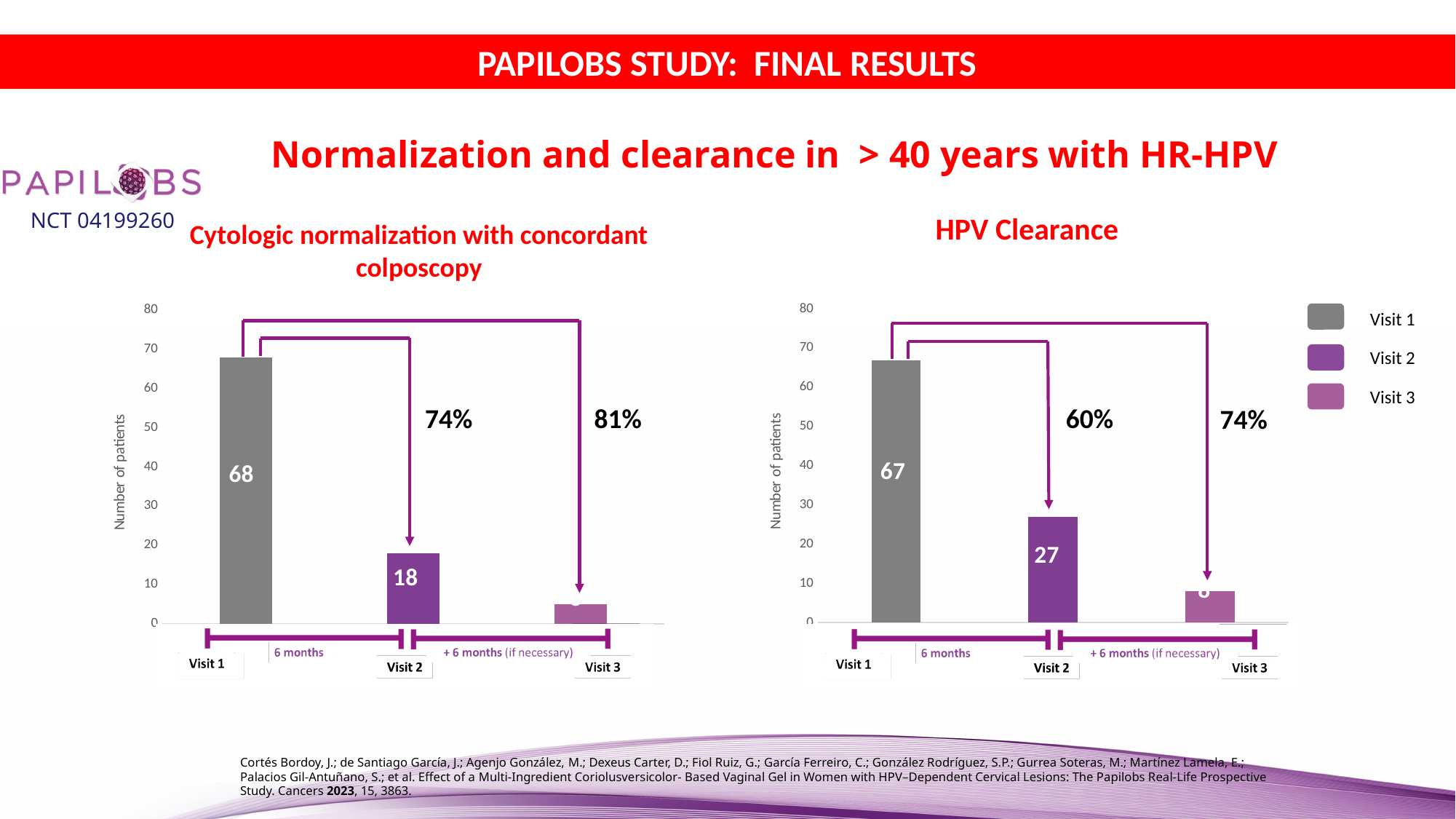
In the Cytologic normalization with concordant colposcopy chart, do the values rise or fall from Visit 1 to Visit 3? fall In the Cytologic normalization with concordant colposcopy chart, which visit has the lowest number of patients? Visit 3 What kind of chart is the HPV Clearance chart? bar chart In the Cytologic normalization with concordant colposcopy chart, what is the difference in number of patients between Visit 1 and Visit 2? 50 In the Cytologic normalization with concordant colposcopy chart, how many patients are shown for Visit 1? 68 In the Cytologic normalization with concordant colposcopy chart, how many patients are shown for Visit 2? 18 In the HPV Clearance chart, how many patients are shown for Visit 2? 27 In the HPV Clearance chart, which visit has the highest number of patients? Visit 1 In the HPV Clearance chart, is the value for Visit 3 greater or less than 10? less In the HPV Clearance chart, how many patients are shown for Visit 1? 67 How many series does the legend on the right of the slide list? 3 In the HPV Clearance chart, what is the difference in number of patients between Visit 1 and Visit 2? 40